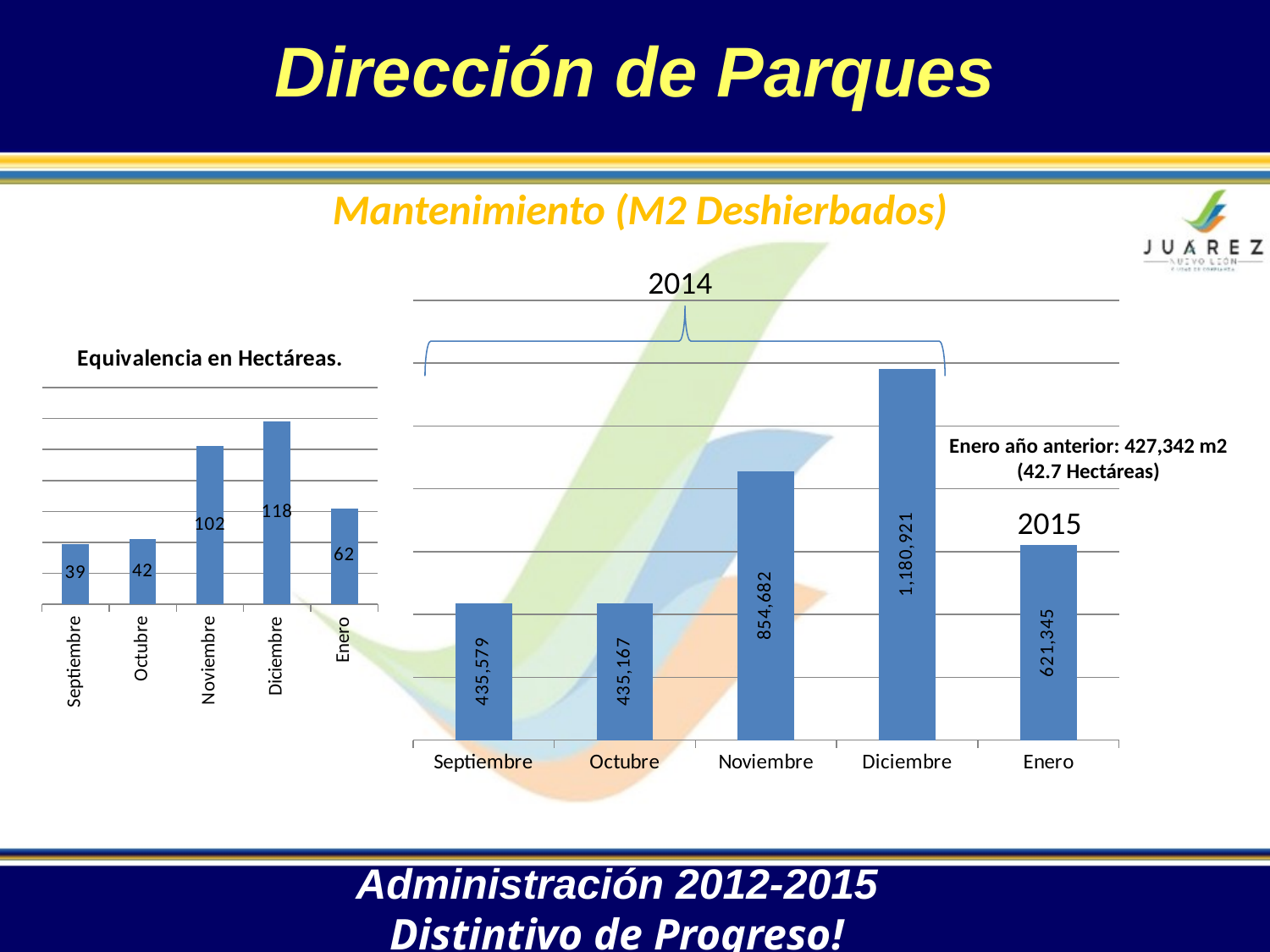
In the Equivalencia en Hectáreas chart, which month has the lowest value? Septiembre In the Equivalencia en Hectáreas chart, what is the value for Septiembre? 39 What type of chart is the Equivalencia en Hectáreas chart? Bar chart In the Mantenimiento (M2 Deshierbados) chart, what is the value for Enero? 621,345 In the Equivalencia en Hectáreas chart, what is the value for Noviembre? 102 In the Mantenimiento (M2 Deshierbados) chart, which is larger, Enero or Noviembre? Noviembre How many months are plotted in the Mantenimiento (M2 Deshierbados) chart? 5 In the Mantenimiento (M2 Deshierbados) chart, what is the value for Diciembre? 1,180,921 In the Mantenimiento (M2 Deshierbados) chart, what is the value for Noviembre? 854,682 In the Mantenimiento (M2 Deshierbados) chart, which month has the highest value? Diciembre In the Equivalencia en Hectáreas chart, what is the difference between Diciembre and Enero? 56 In the Mantenimiento (M2 Deshierbados) chart, what is the difference between Diciembre and Noviembre? 326,239